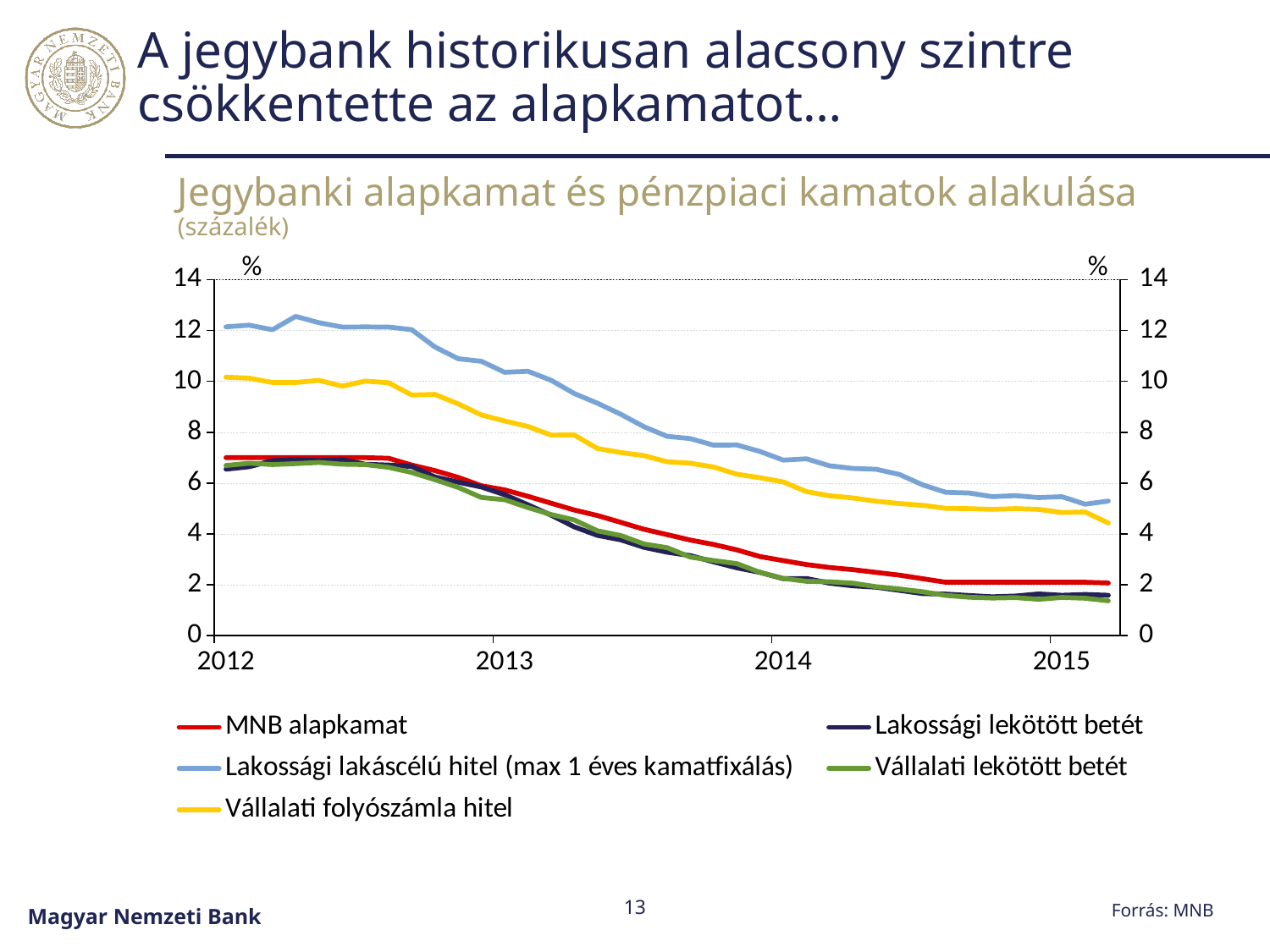
What colour is the MNB alapkamat line? red How many series does the legend list? 5 Does the MNB alapkamat series rise or fall from 2012 to 2015? fall Is the value of Vállalati folyószámla hitel at the end of the series in 2015 greater or less than 6? less What kind of chart is shown on the slide? line chart Is the value of Lakossági lakáscélú hitel (max 1 éves kamatfixálás) at the start of 2012 greater or less than 10? greater At the start of 2012, which is higher: Lakossági lakáscélú hitel (max 1 éves kamatfixálás) or Vállalati folyószámla hitel? Lakossági lakáscélú hitel (max 1 éves kamatfixálás) Is the value of MNB alapkamat at the start of 2012 greater or less than 6? greater What is the title of the chart? Jegybanki alapkamat és pénzpiaci kamatok alakulása In 2015, which is higher: MNB alapkamat or Vállalati lekötött betét? MNB alapkamat Which series has the highest values throughout the whole period? Lakossági lakáscélú hitel (max 1 éves kamatfixálás)